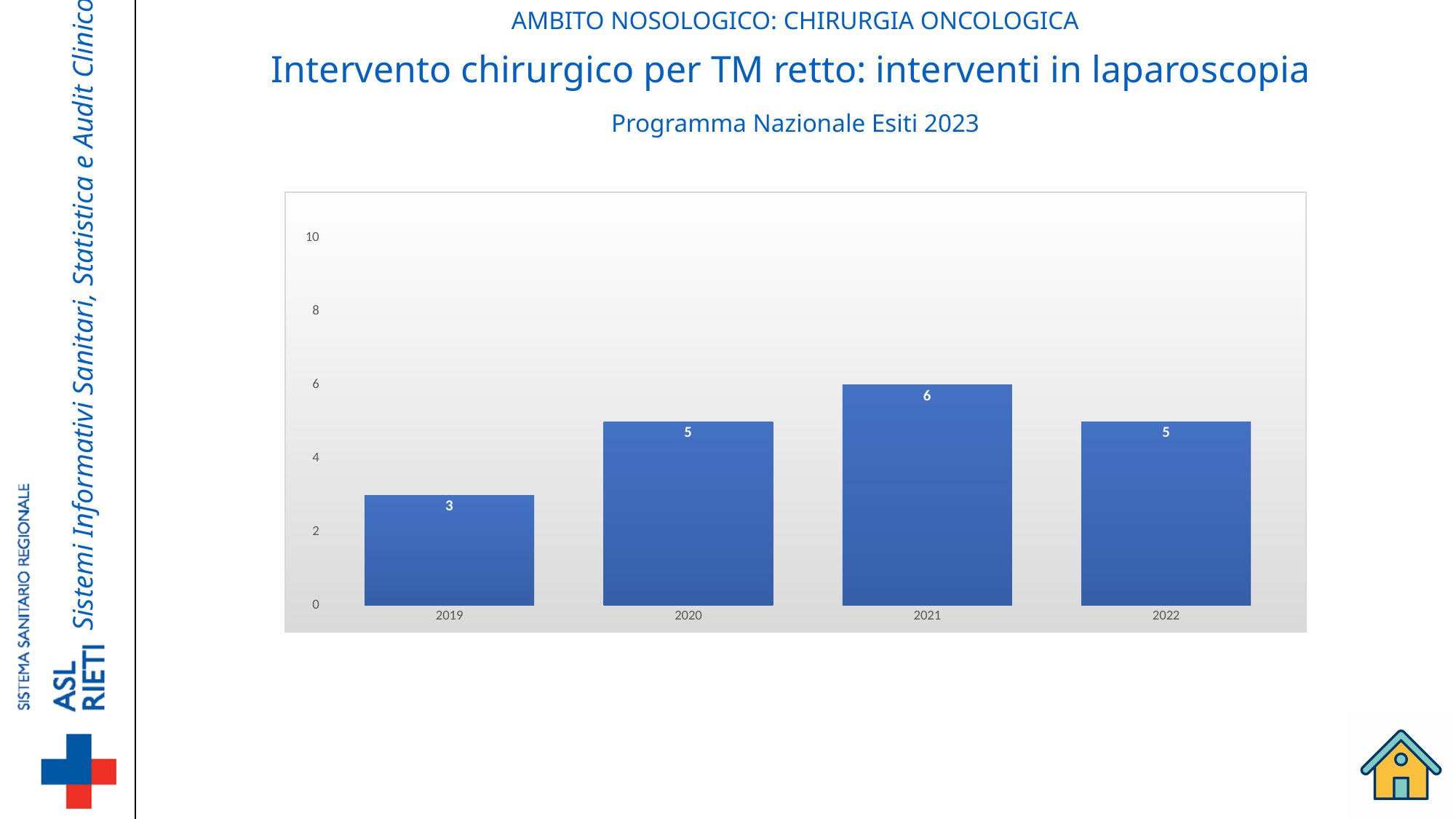
What is the value for 2019? 3 How many years are shown on the x axis? 4 Does the value rise or fall from 2019 to 2021? rise What is the highest value shown on the y axis? 10 What is the difference between the values for 2021 and 2019? 3 Which year has the lowest value? 2019 Which year has the highest value? 2021 Which is larger, the value for 2020 or the value for 2019? 2020 What is the value for 2021? 6 What kind of chart is shown on the slide? bar chart What is the value for 2022? 5 Is the value for 2021 greater or less than 4? greater